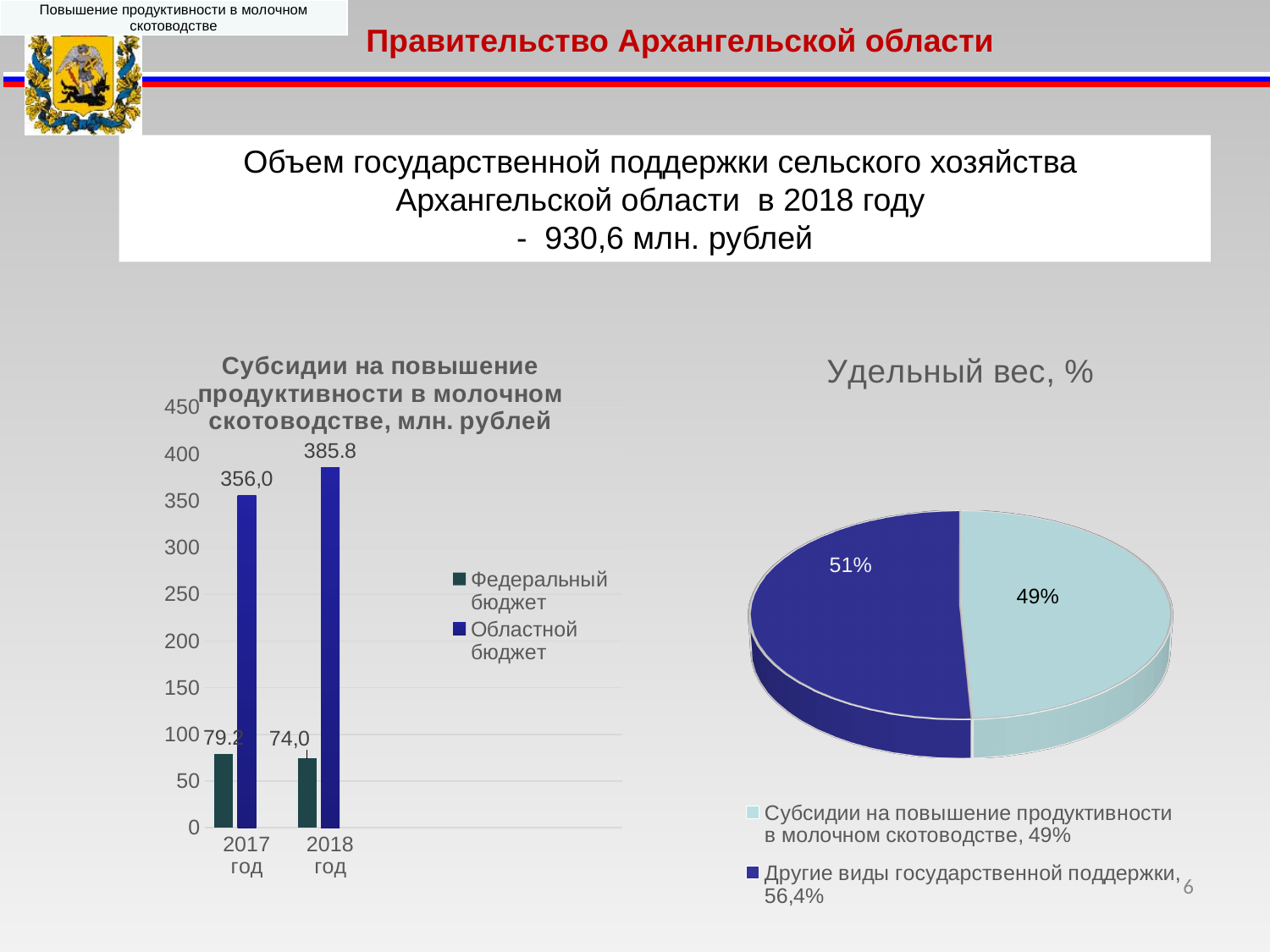
In the bar chart on the left, which series has the higher value in 2018 год, Федеральный бюджет or Областной бюджет? Областной бюджет What kind of chart is the chart titled 'Удельный вес, %'? pie chart In the bar chart 'Субсидии на повышение продуктивности в молочном скотоводстве, млн. рублей', what is the value for Федеральный бюджет in 2018 год? 74,0 In the bar chart on the left, does the value for Областной бюджет rise or fall from 2017 год to 2018 год? rise In the bar chart on the left, how many year categories are shown on the x axis? 2 In the bar chart 'Субсидии на повышение продуктивности в молочном скотоводстве, млн. рублей', what is the value for Федеральный бюджет in 2017 год? 79.2 In the pie chart 'Удельный вес, %', which slice is larger, the 49% slice or the 51% slice? 51% In the bar chart 'Субсидии на повышение продуктивности в молочном скотоводстве, млн. рублей', what is the value for Областной бюджет in 2018 год? 385.8 In the bar chart on the left, how many series does the legend list? 2 In the pie chart 'Удельный вес, %', what share is labelled on the slice for Субсидии на повышение продуктивности в молочном скотоводстве? 49% In the bar chart 'Субсидии на повышение продуктивности в молочном скотоводстве, млн. рублей', what is the value for Областной бюджет in 2017 год? 356,0 In the bar chart on the left, does the value for Федеральный бюджет rise or fall from 2017 год to 2018 год? fall